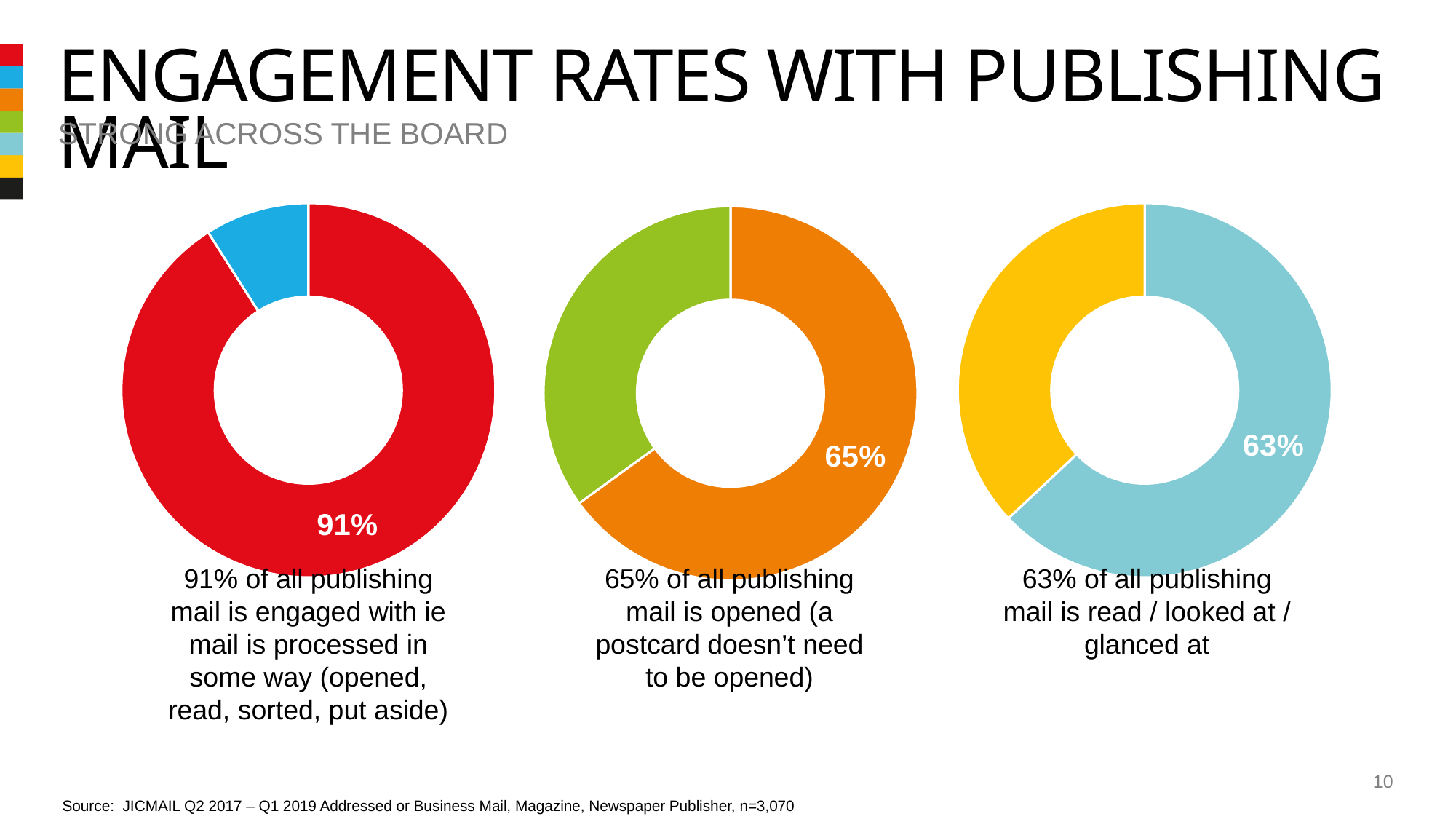
Which of the three charts shows the lowest labelled percentage? The right chart (63%) On the left chart, what percentage is shown on the large red slice? 91% How many charts are shown on the slide? 3 On the right chart, what percentage is shown on the light blue slice? 63% What is the difference between the labelled percentage on the left chart and the labelled percentage on the middle chart? 26 percentage points On the middle chart, what colour is the larger slice? Orange What is the difference between the labelled percentage on the middle chart and the labelled percentage on the right chart? 2 percentage points How many slices does the left chart have? 2 Which of the three charts shows the highest labelled percentage? The left chart (91%) What kind of chart is used for each of the three charts on the slide? Pie chart (donut) Which is larger: the labelled percentage on the middle chart or the labelled percentage on the right chart? The middle chart (65%) On the middle chart, what percentage is shown on the orange slice? 65%